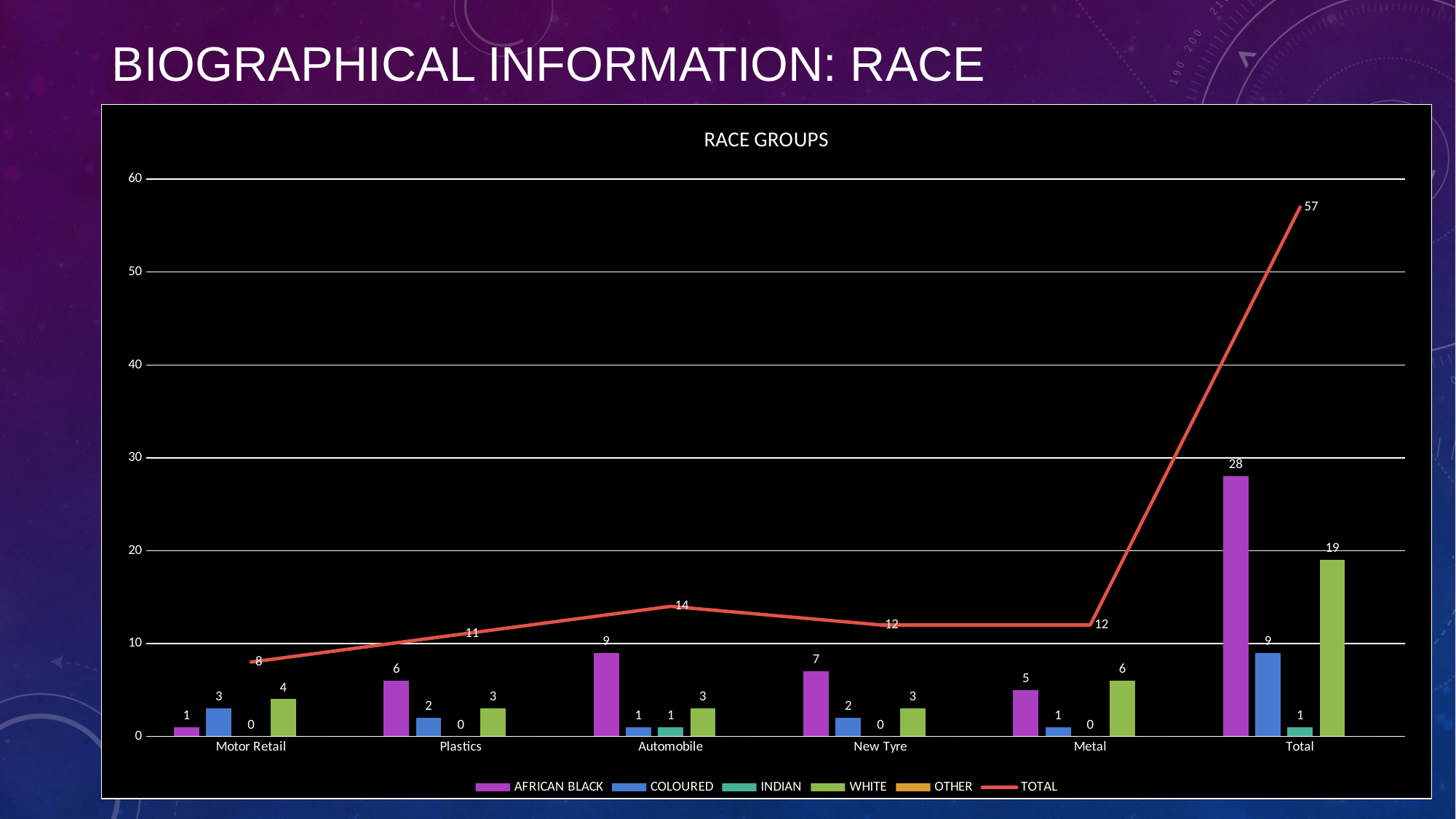
How many series does the legend list? 6 What is the COLOURED value for the Total category? 9 What is the title of the chart? RACE GROUPS What is the value of the TOTAL line for Automobile? 14 What is the WHITE value for Metal? 6 What is the difference between the AFRICAN BLACK and WHITE values in the Total category? 9 How many categories are shown on the x axis? 6 Which is larger for Metal: the AFRICAN BLACK value or the WHITE value? WHITE Excluding the Total category, which category has the lowest TOTAL line value? Motor Retail Which category has the highest TOTAL line value? Total What is the AFRICAN BLACK value for Plastics? 6 What kind of chart is this? Combination bar and line chart